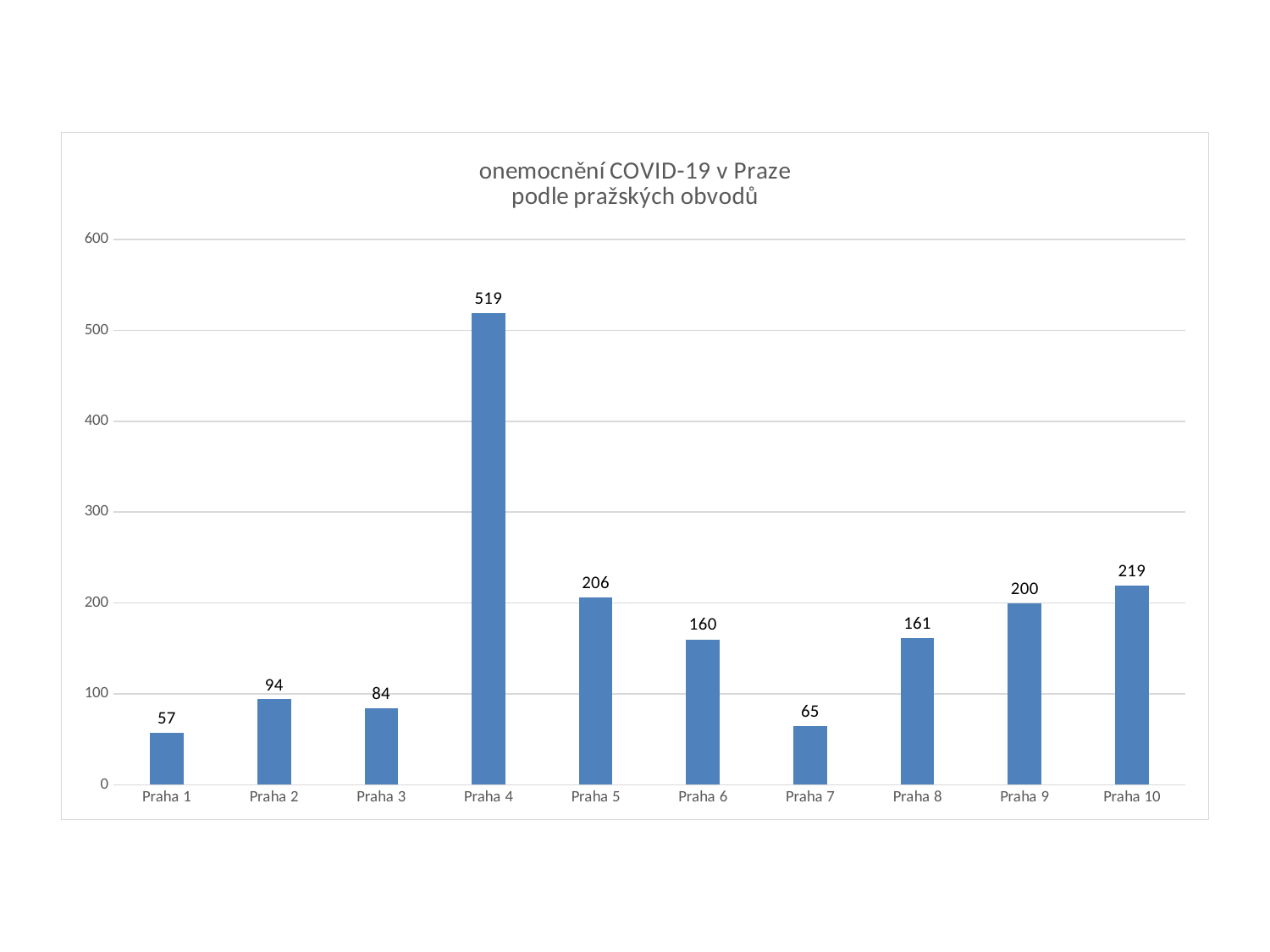
What kind of chart is shown on the slide? bar chart What is the difference between the values for Praha 4 and Praha 5? 313 Which district has the lowest value? Praha 1 What is the difference between the values for Praha 10 and Praha 9? 19 What is the title of the chart? onemocnění COVID-19 v Praze podle pražských obvodů What is the value for Praha 10? 219 Is the value for Praha 5 greater or less than 200? greater What is the value for Praha 7? 65 Which is larger, the value for Praha 2 or the value for Praha 3? Praha 2 What is the value for Praha 4? 519 Which district has the highest value? Praha 4 How many districts are shown on the x axis? 10